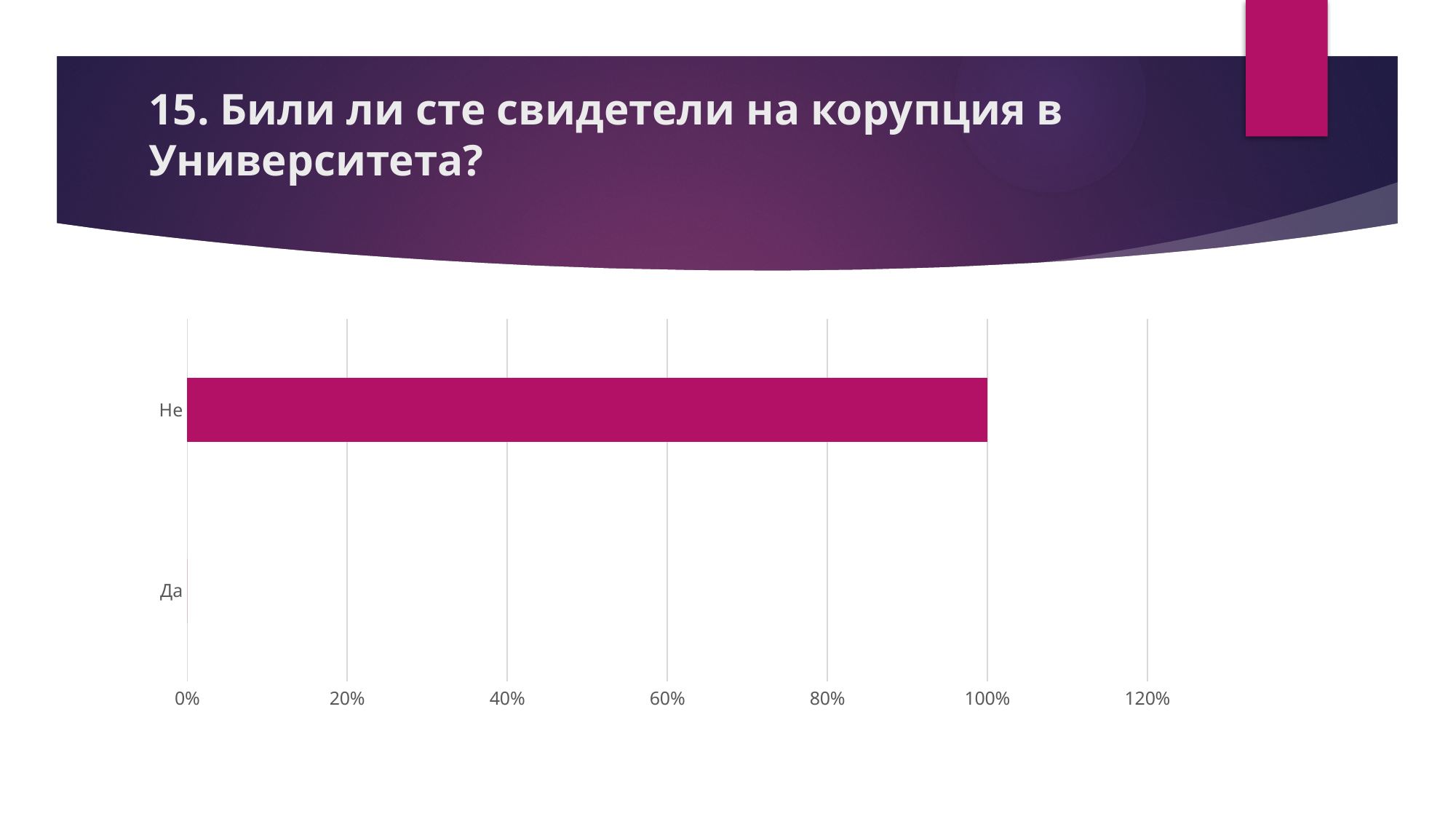
Is the value for "Не" greater or less than 120%? less How many categories are shown on the chart? 2 Which is larger, the value for "Не" or the value for "Да"? Не What is the value for "Не"? 100% Is the value for "Не" greater or less than 80%? greater Which category has the highest value? Не Which category has the lowest value? Да What is the highest value labelled on the horizontal axis? 120% What kind of chart is shown on the slide? bar chart What is the title of the slide containing the chart? 15. Били ли сте свидетели на корупция в Университета? Is the value for "Да" greater or less than 20%? less